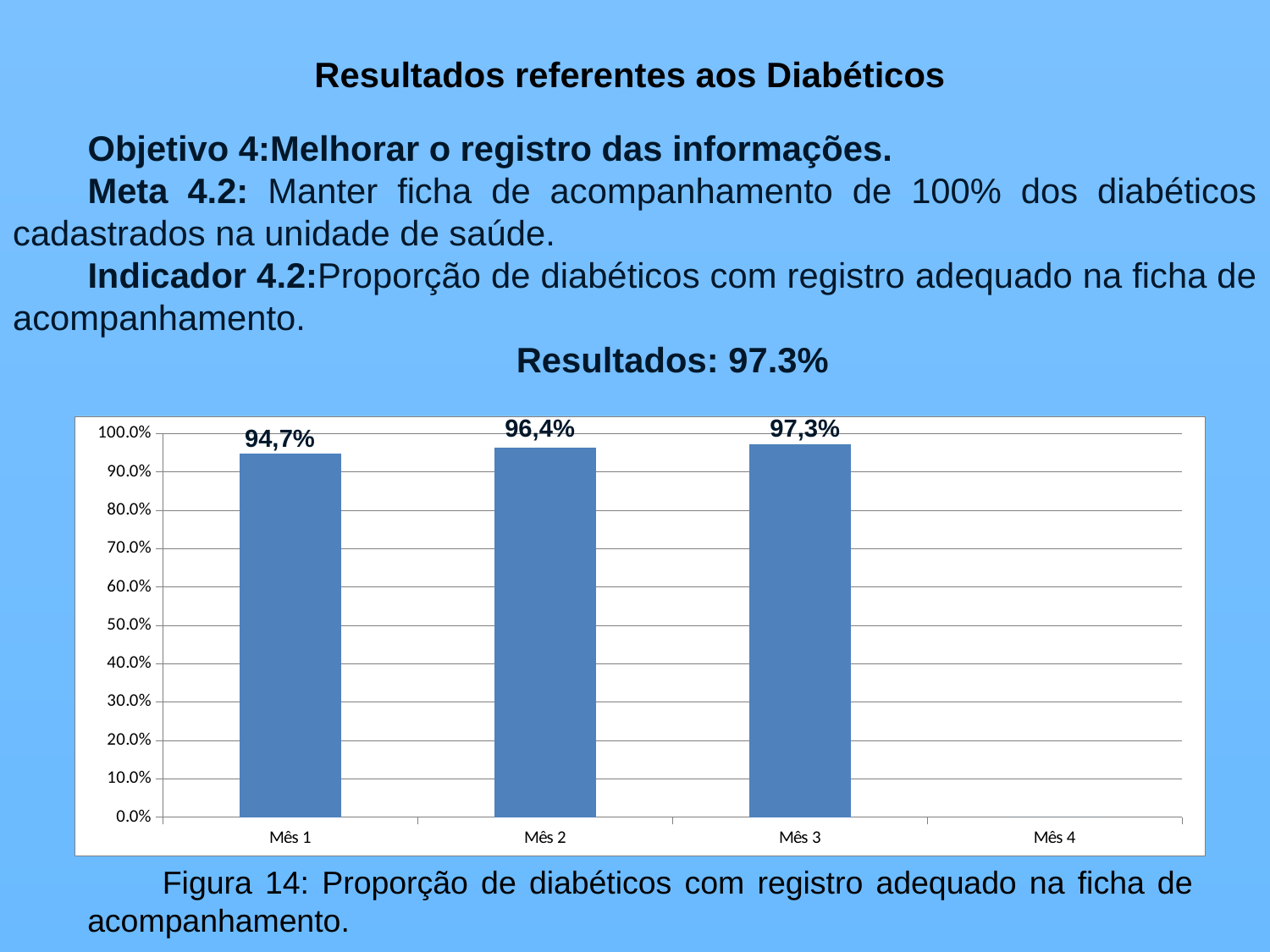
How many bars are plotted in the chart? 3 Which month has the highest value? Mês 3 What is the difference between the values for Mês 3 and Mês 1? 2,6% Which month with a plotted bar has the lowest value? Mês 1 Which is larger, the value for Mês 2 or the value for Mês 3? Mês 3 What is the value for Mês 1? 94,7% What is the value for Mês 2? 96,4% What kind of chart is shown on the slide? bar chart Do the values rise or fall from Mês 1 to Mês 3? rise What is the value for Mês 3? 97,3% Is the value for Mês 1 greater or less than 90.0%? greater What is the difference between the values for Mês 2 and Mês 1? 1,7%